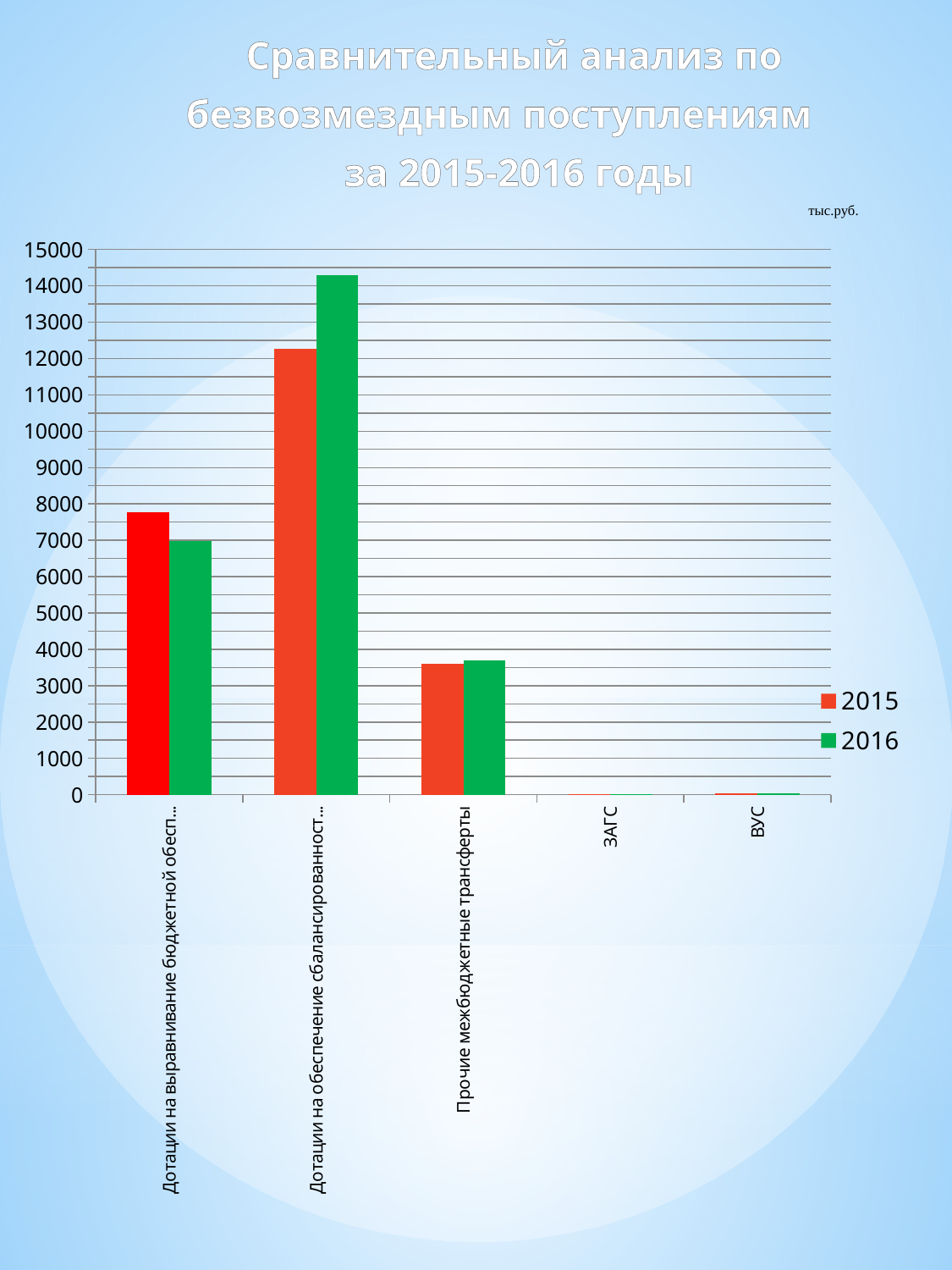
For Дотации на выравнивание бюджетной обесп…, which year has the larger value, 2015 or 2016? 2015 Is the 2016 value for Дотации на выравнивание бюджетной обесп… greater or less than 6000? greater Is the 2016 value for Дотации на обеспечение сбалансированност… greater or less than 14000? greater Is the 2015 value for Прочие межбюджетные трансферты greater or less than 4000? less Which colour represents the 2016 series in the legend? green How many series does the legend list? 2 How many categories are shown on the x axis? 5 What kind of chart is shown on the slide? bar chart For Дотации на обеспечение сбалансированност…, which year has the larger value, 2015 or 2016? 2016 Which category has the tallest bar in the chart? Дотации на обеспечение сбалансированност…